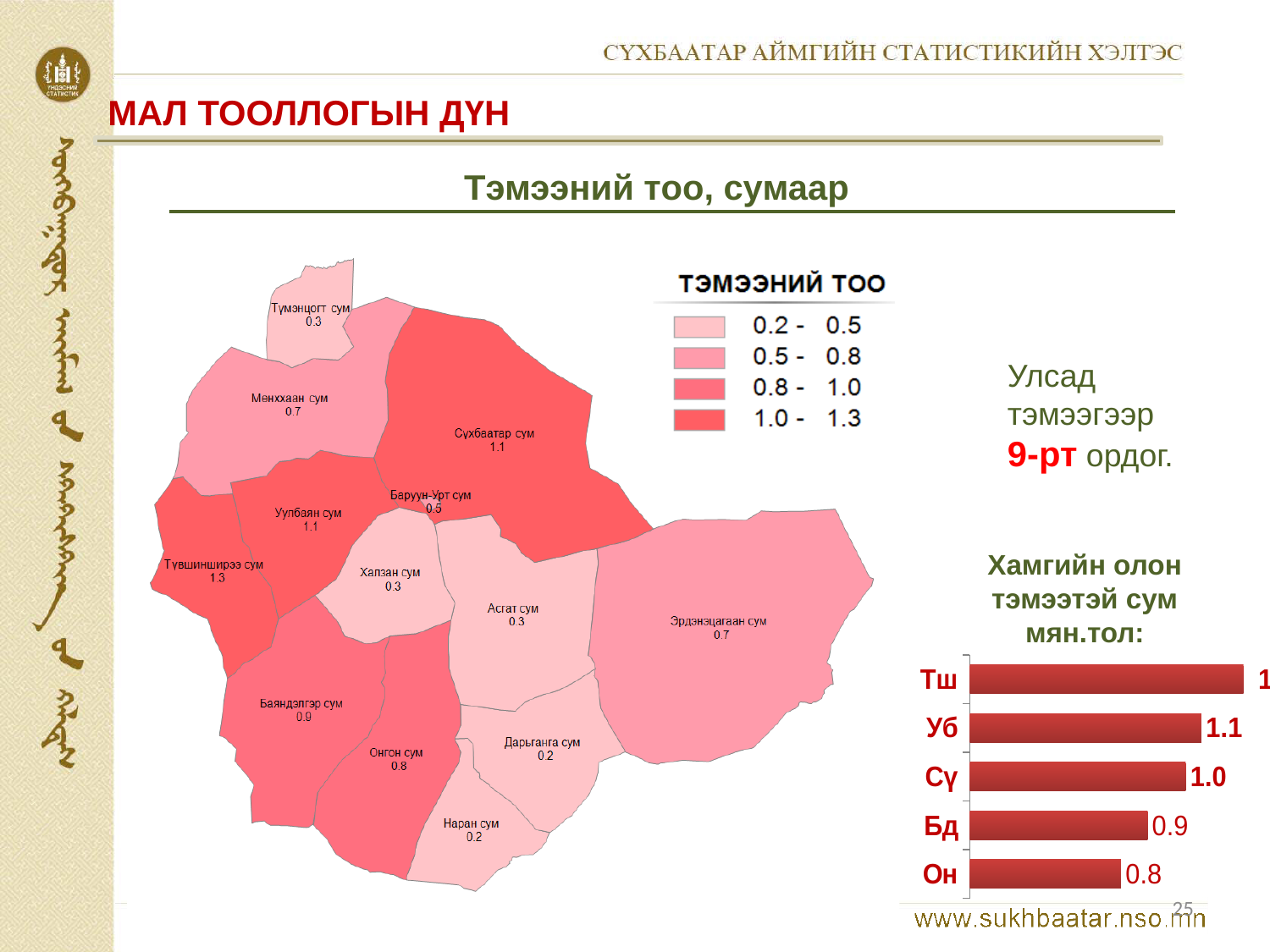
In the bar chart 'Хамгийн олон тэмээтэй сум мян.тол:', how many categories (sums) are plotted? 5 In the bar chart 'Хамгийн олон тэмээтэй сум мян.тол:', what is the difference between the values for Уб and Он? 0.3 In the bar chart 'Хамгийн олон тэмээтэй сум мян.тол:', do the values increase or decrease going from the top bar to the bottom bar? decrease In the bar chart 'Хамгийн олон тэмээтэй сум мян.тол:', what is the value for Бд? 0.9 In the bar chart 'Хамгийн олон тэмээтэй сум мян.тол:', which category has the lowest value? Он In the bar chart 'Хамгийн олон тэмээтэй сум мян.тол:', what is the value for Уб? 1.1 What is the title printed above the bar chart on the right side of the slide? Хамгийн олон тэмээтэй сум мян.тол: In the bar chart 'Хамгийн олон тэмээтэй сум мян.тол:', what is the value for Он? 0.8 What kind of chart is shown on the right side of the slide under 'Хамгийн олон тэмээтэй сум мян.тол:'? bar chart In the bar chart 'Хамгийн олон тэмээтэй сум мян.тол:', what is the value for Сү? 1.0 In the bar chart 'Хамгийн олон тэмээтэй сум мян.тол:', which is larger, the value for Сү or the value for Бд? Сү In the bar chart 'Хамгийн олон тэмээтэй сум мян.тол:', which category has the longest bar? Тш